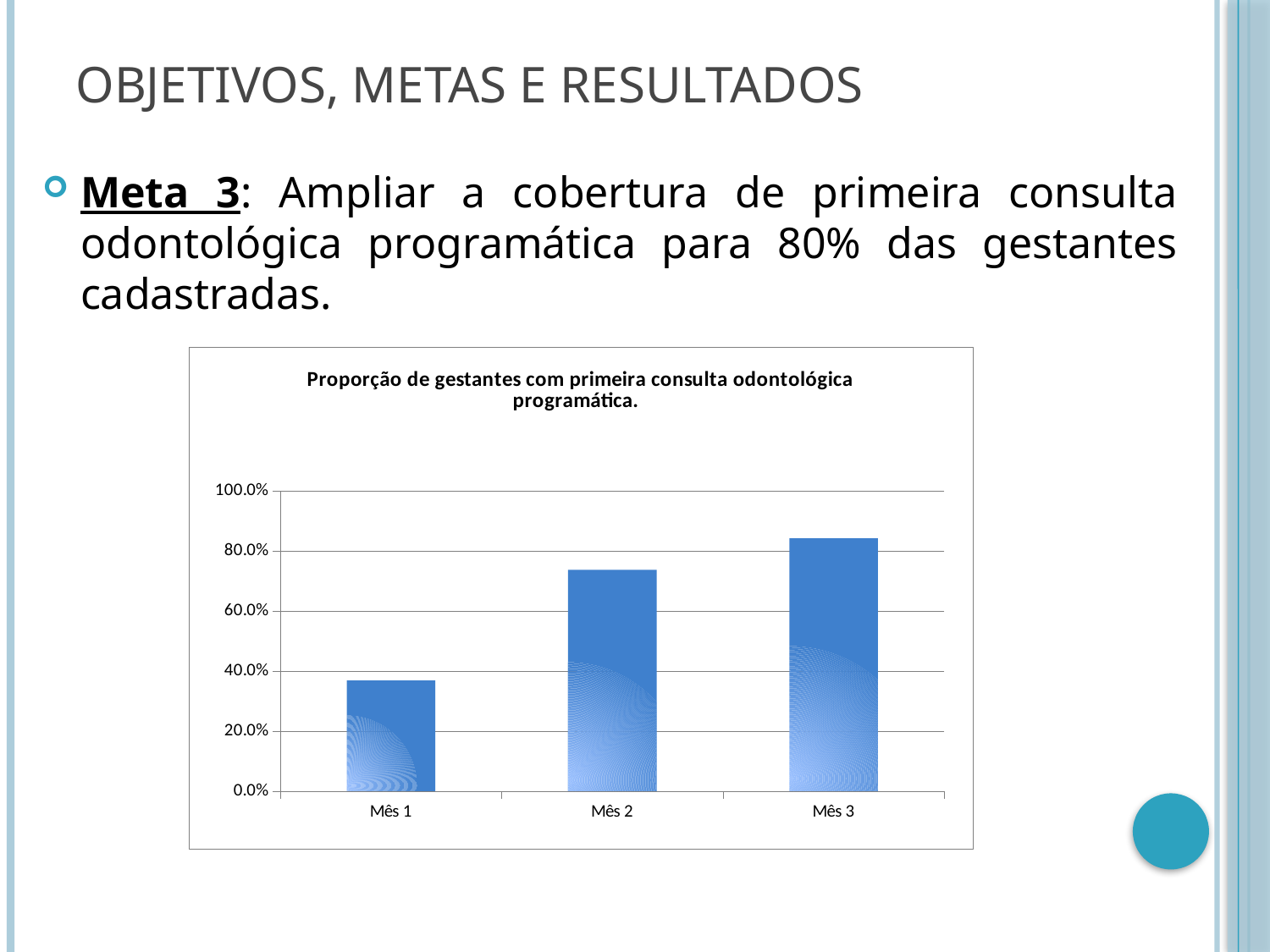
Is the value for Mês 2 greater or less than 60.0%? greater Is the value for Mês 3 greater or less than 100.0%? less Which is larger, the value for Mês 1 or the value for Mês 2? Mês 2 Which is larger, the value for Mês 2 or the value for Mês 3? Mês 3 Which month has the lowest proportion of pregnant women with a first programmatic dental consultation? Mês 1 Do the values rise or fall from Mês 1 to Mês 3? rise What is the title of the chart? Proporção de gestantes com primeira consulta odontológica programática. What kind of chart is shown on the slide? bar chart Is the value for Mês 1 greater or less than 20.0%? greater Which month has the highest proportion of pregnant women with a first programmatic dental consultation? Mês 3 How many categories (months) are plotted on the chart? 3